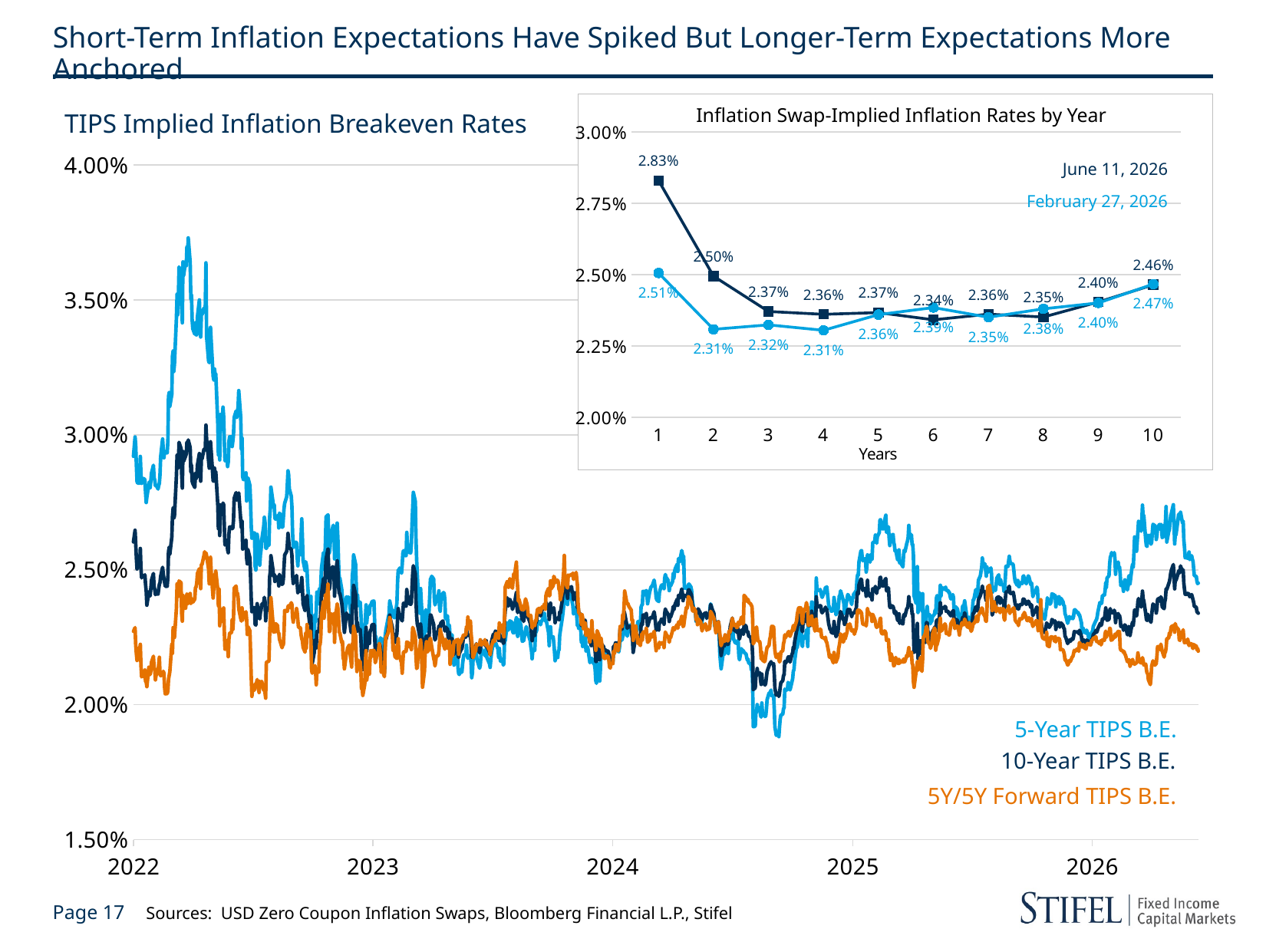
How many series does the legend of the 'TIPS Implied Inflation Breakeven Rates' chart list? 3 In the 'TIPS Implied Inflation Breakeven Rates' chart, which series is drawn in orange? 5Y/5Y Forward TIPS B.E. In the 'Inflation Swap-Implied Inflation Rates by Year' chart, at which year is the June 11, 2026 series highest? 1 In the 'TIPS Implied Inflation Breakeven Rates' chart, is the peak of the 5-Year TIPS B.E. series in 2022 greater or less than 3.50%? greater In the 'Inflation Swap-Implied Inflation Rates by Year' chart, what is the difference between the June 11, 2026 and February 27, 2026 values at year 1? 0.32% In the 'Inflation Swap-Implied Inflation Rates by Year' chart, what is the lowest value of the June 11, 2026 series? 2.34% In the 'Inflation Swap-Implied Inflation Rates by Year' chart, what is the February 27, 2026 value at year 2? 2.31% In the 'Inflation Swap-Implied Inflation Rates by Year' chart, which series has the larger value at year 2, June 11, 2026 or February 27, 2026? June 11, 2026 In the 'Inflation Swap-Implied Inflation Rates by Year' chart, what is the June 11, 2026 value at year 10? 2.46% What kind of chart is 'TIPS Implied Inflation Breakeven Rates'? Line chart How many years are plotted on the x axis of the 'Inflation Swap-Implied Inflation Rates by Year' chart? 10 In the 'Inflation Swap-Implied Inflation Rates by Year' chart, what is the June 11, 2026 value at year 1? 2.83%